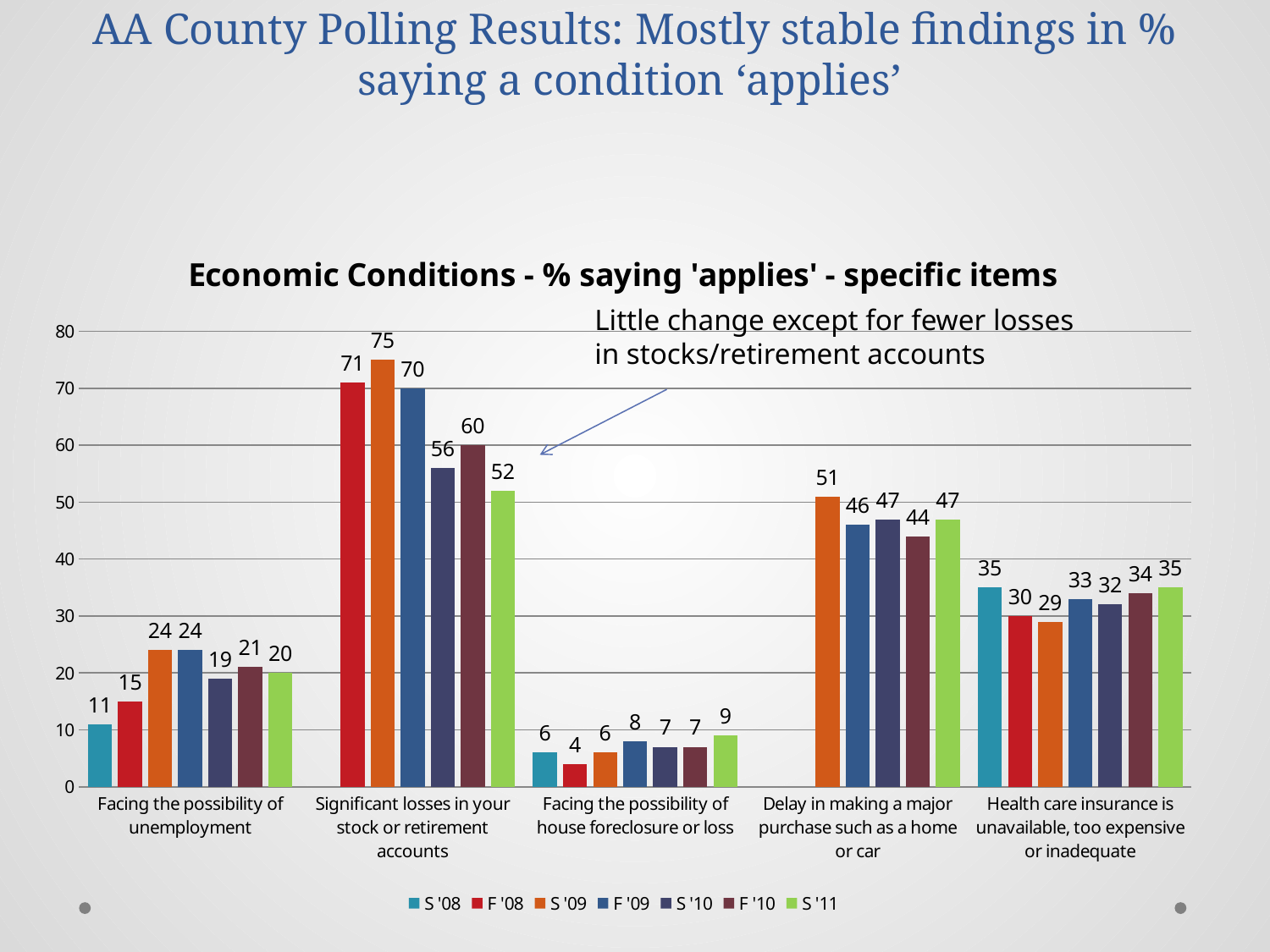
How many series does the legend list? 7 What is the F '10 value for 'Delay in making a major purchase such as a home or car'? 44 Which survey wave has the highest value for 'Significant losses in your stock or retirement accounts'? S '09 How many categories are shown on the x axis? 5 What is the S '11 value for 'Significant losses in your stock or retirement accounts'? 52 What kind of chart is shown on the slide? Bar chart What is the S '09 value for 'Delay in making a major purchase such as a home or car'? 51 Which is larger for 'Health care insurance is unavailable, too expensive or inadequate': the S '08 value or the S '09 value? S '08 What is the S '08 value for 'Facing the possibility of unemployment'? 11 What is the difference between the S '09 and S '11 values for 'Significant losses in your stock or retirement accounts'? 23 What is the title of the chart? Economic Conditions - % saying 'applies' - specific items Which survey wave has the lowest value for 'Facing the possibility of house foreclosure or loss'? F '08